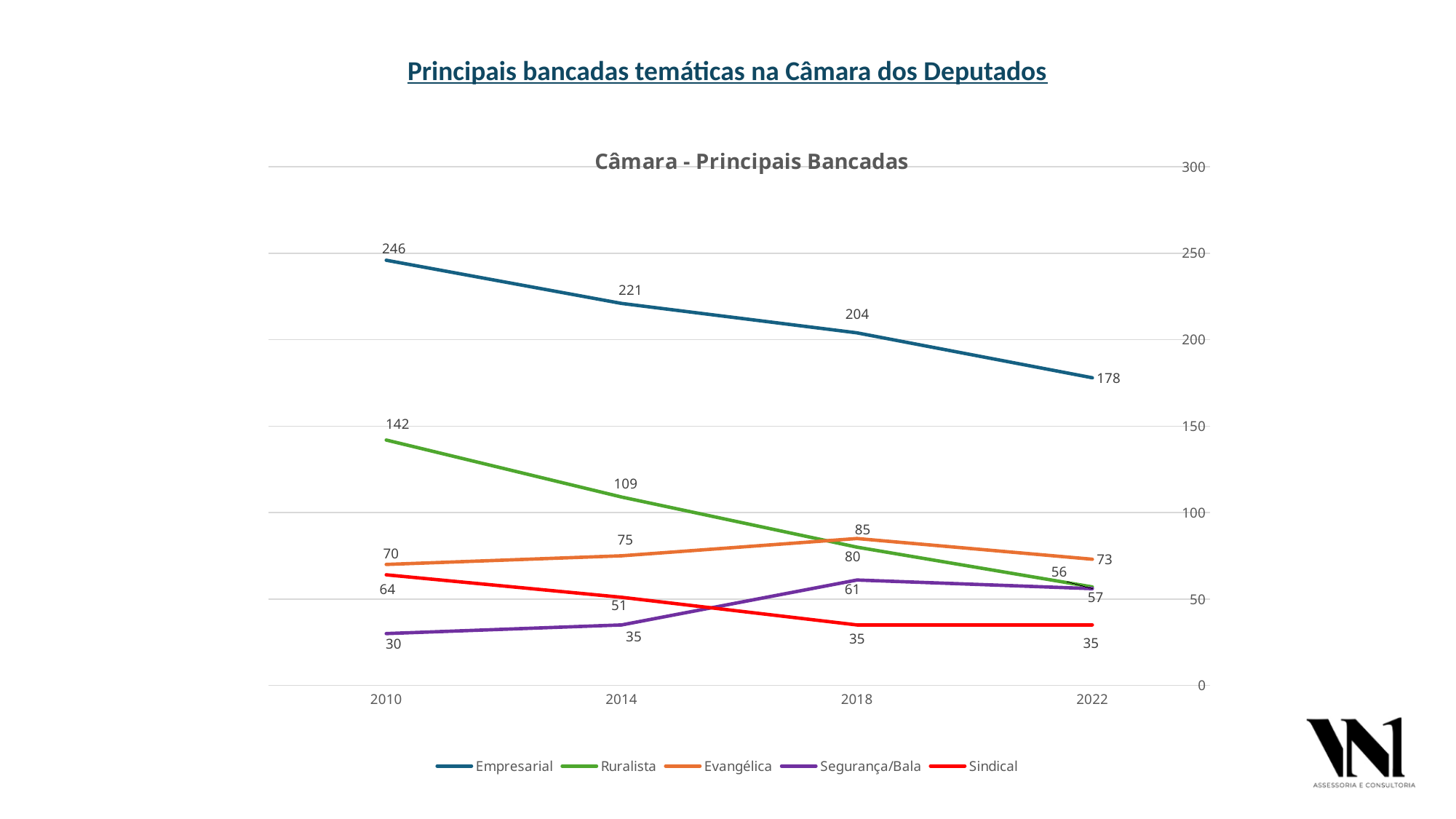
What is the value for Segurança/Bala in 2014? 35 How many years are shown on the x axis? 4 What is the difference between the Empresarial values in 2010 and 2022? 68 What is the value for Evangélica in 2022? 73 How many series does the legend list? 5 Which series has the highest value in 2022? Empresarial What is the value for Ruralista in 2018? 80 Which is larger in 2018, Evangélica or Ruralista? Evangélica Does the Ruralista series rise or fall from 2010 to 2022? fall What is the value for Empresarial in 2010? 246 Which series has the lowest value in 2010? Segurança/Bala What type of chart is shown on the slide? line chart